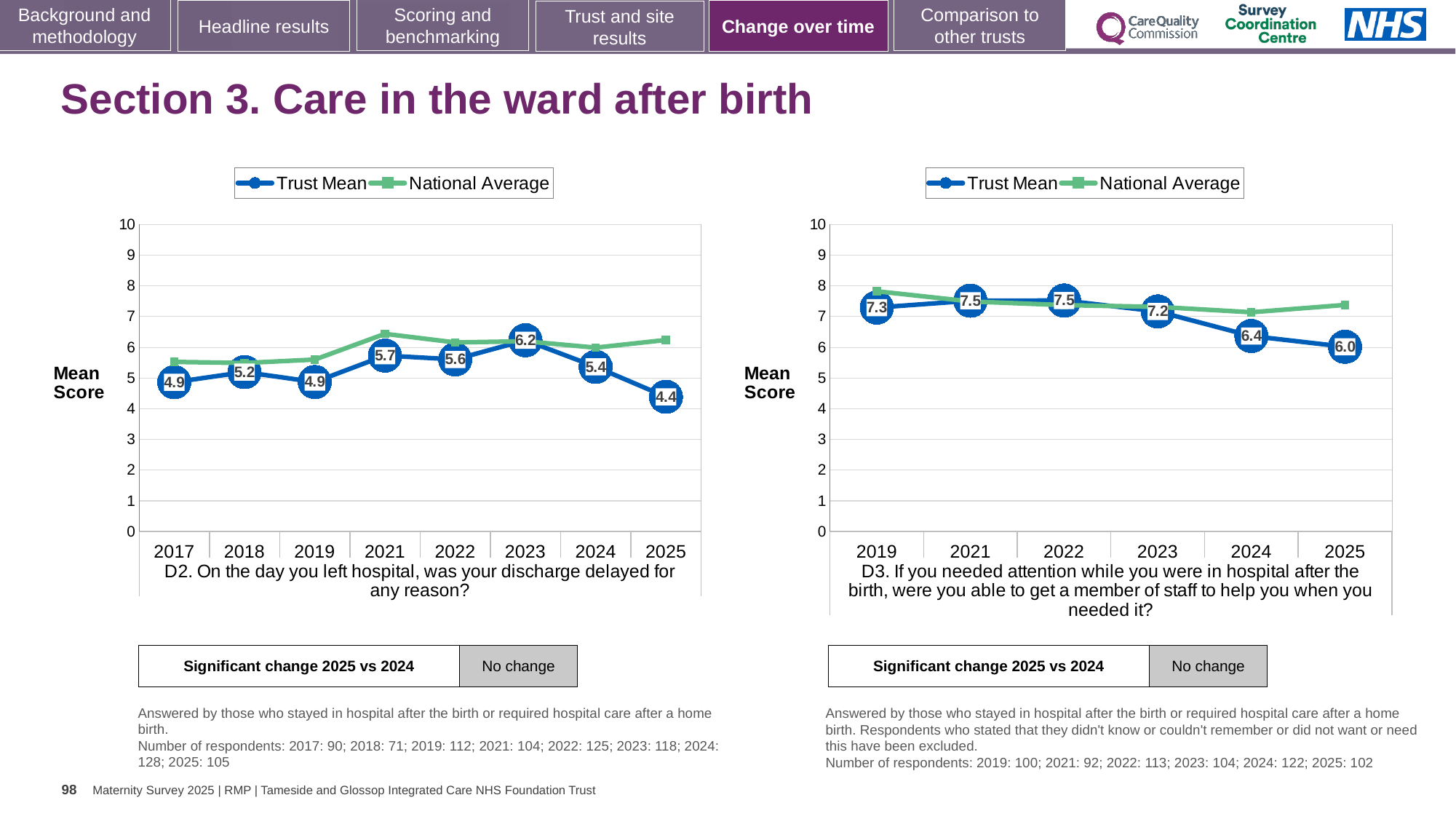
In the D3 chart (right), does the Trust Mean rise or fall from 2022 to 2025? fall In the D3 chart (right), how many years are shown on the x axis? 6 In the D2 chart (left), which year has the highest Trust Mean score? 2023 In the D2 chart (left), what is the difference between the Trust Mean scores for 2023 and 2025? 1.8 In the D2 chart (left), what is the Trust Mean score for 2025? 4.4 In the D3 chart (right), which is larger, the Trust Mean for 2019 or for 2025? 2019 In the D2 chart (left), is the National Average for 2021 greater or less than 6? greater How many series does the legend of the D3 chart (right) list? 2 In the D2 chart (left), what is the Trust Mean score for 2023? 6.2 What kind of chart is the D2 chart (left)? line chart In the D2 chart (left), which year has the lowest Trust Mean score? 2025 In the D3 chart (right), what is the Trust Mean score for 2024? 6.4